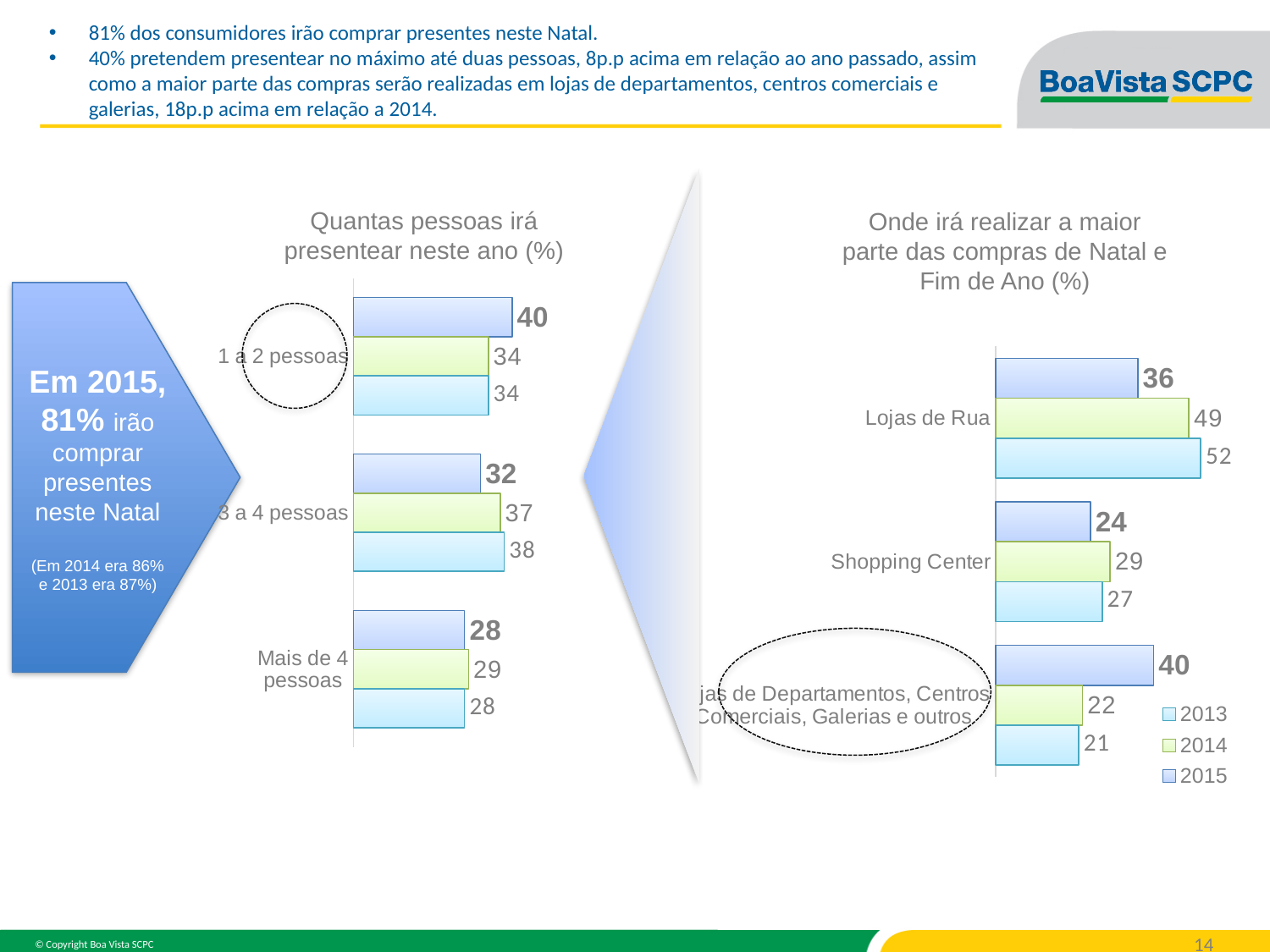
In the chart 'Quantas pessoas irá presentear neste ano (%)', what is the 2015 value for '1 a 2 pessoas'? 40 In the chart 'Quantas pessoas irá presentear neste ano (%)', which category has the highest 2015 value? 1 a 2 pessoas In the chart 'Onde irá realizar a maior parte das compras de Natal e Fim de Ano (%)', what is the 2013 value for 'Lojas de Rua'? 52 How many series does the legend of the chart 'Onde irá realizar a maior parte das compras de Natal e Fim de Ano (%)' list? 3 In the chart 'Quantas pessoas irá presentear neste ano (%)', what is the difference between the 2015 and 2014 values for '1 a 2 pessoas'? 6 In the chart 'Onde irá realizar a maior parte das compras de Natal e Fim de Ano (%)', what is the 2015 value for 'Shopping Center'? 24 In the chart 'Quantas pessoas irá presentear neste ano (%)', what is the 2013 value for '3 a 4 pessoas'? 38 In the chart 'Onde irá realizar a maior parte das compras de Natal e Fim de Ano (%)', which is larger for 'Shopping Center': the 2014 value or the 2013 value? 2014 In the chart 'Onde irá realizar a maior parte das compras de Natal e Fim de Ano (%)', what is the 2014 value for 'Lojas de Departamentos, Centros Comerciais, Galerias e outros'? 22 In the chart 'Onde irá realizar a maior parte das compras de Natal e Fim de Ano (%)', which category has the lowest 2013 value? Lojas de Departamentos, Centros Comerciais, Galerias e outros In the chart 'Onde irá realizar a maior parte das compras de Natal e Fim de Ano (%)', what is the difference between the 2013 and 2015 values for 'Lojas de Rua'? 16 In the chart 'Quantas pessoas irá presentear neste ano (%)', what is the 2014 value for 'Mais de 4 pessoas'? 29